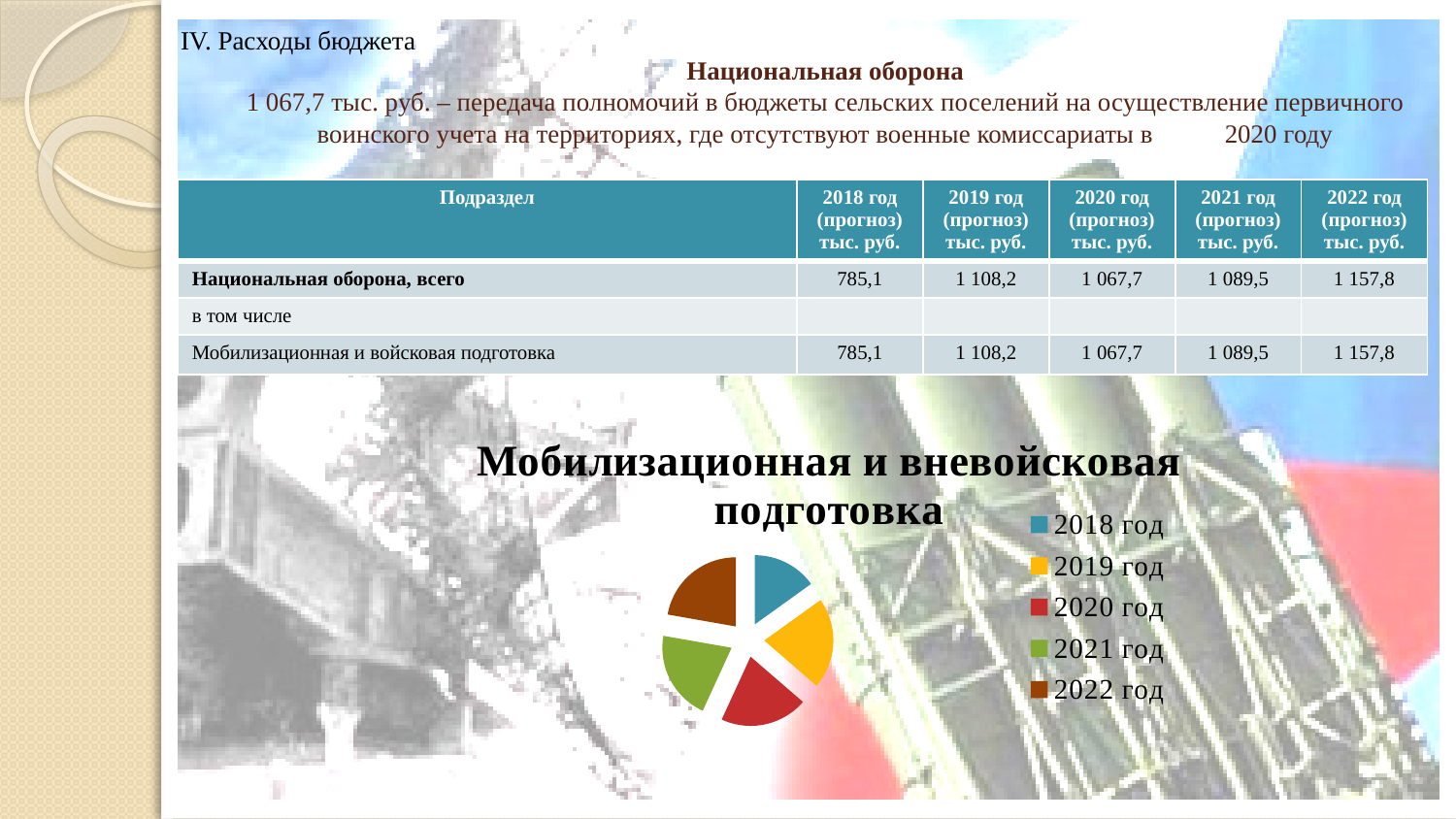
How many slices does the pie chart have? 5 In the pie chart, which slice is larger: 2018 год or 2022 год? 2022 год In the pie chart, which slice is larger: 2018 год or 2019 год? 2019 год In the pie chart, which slice is larger: 2018 год or 2020 год? 2020 год How many entries does the legend of the pie chart list? 5 Which year has the smallest slice in the pie chart? 2018 год What kind of chart is shown on the slide? pie chart Which legend entry is listed first in the pie chart's legend? 2018 год What is the title of the pie chart? Мобилизационная и вневойсковая подготовка Which colour represents 2018 год in the pie chart? blue